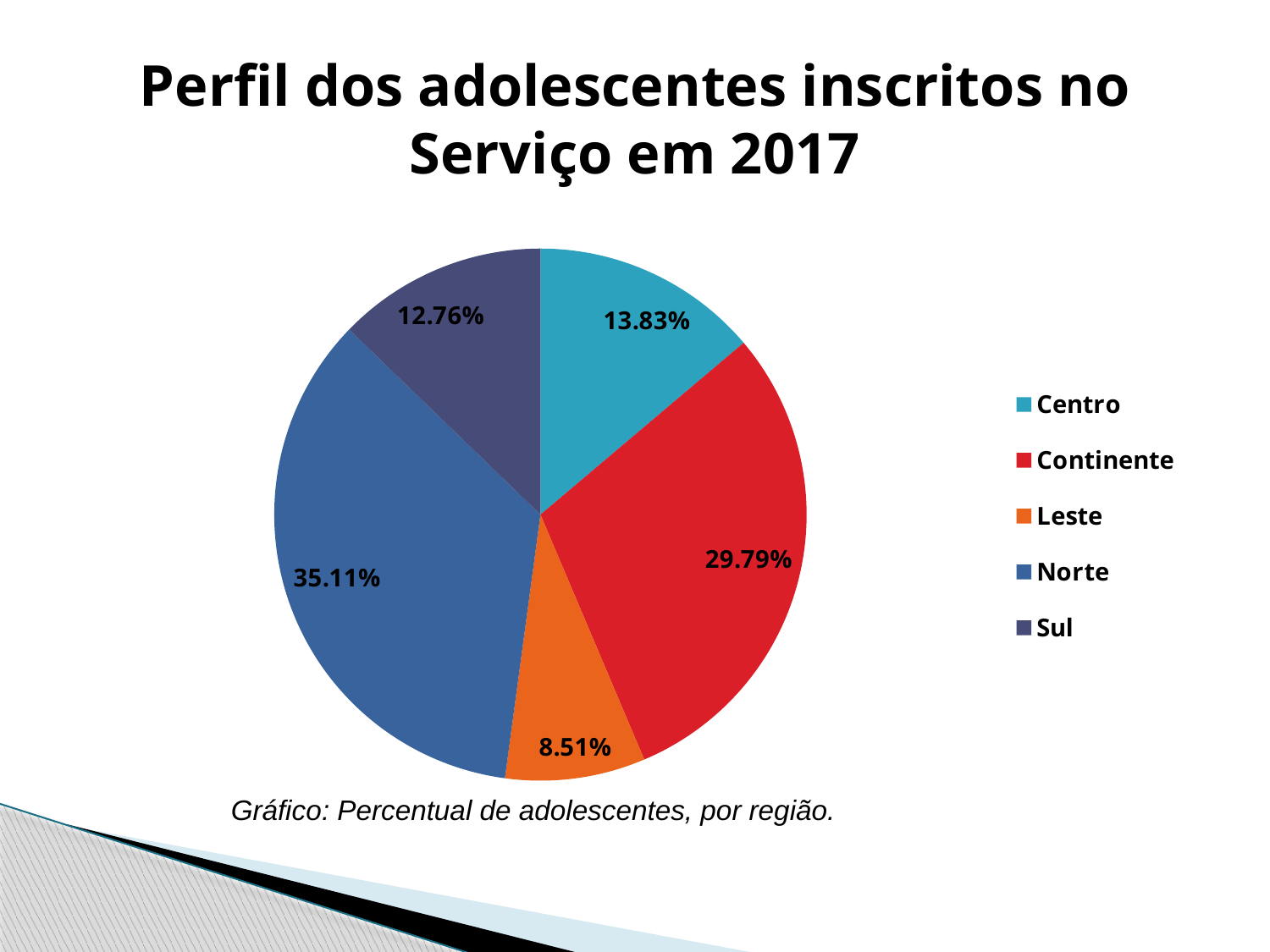
What is the difference in percentage points between the Norte and Continente shares? 5.32 Which region has the smallest share of adolescents? Leste What percentage of adolescents are from the Sul region? 12.76% Which region has a larger share, Centro or Sul? Centro What percentage of adolescents are from the Leste region? 8.51% What colour is the slice representing the Continente region? Red What percentage of adolescents are from the Norte region? 35.11% How many regions are shown in the pie chart? 5 What type of chart is shown on the slide? Pie chart Which region has the largest share of adolescents? Norte What percentage of adolescents are from the Centro region? 13.83% What percentage of adolescents are from the Continente region? 29.79%